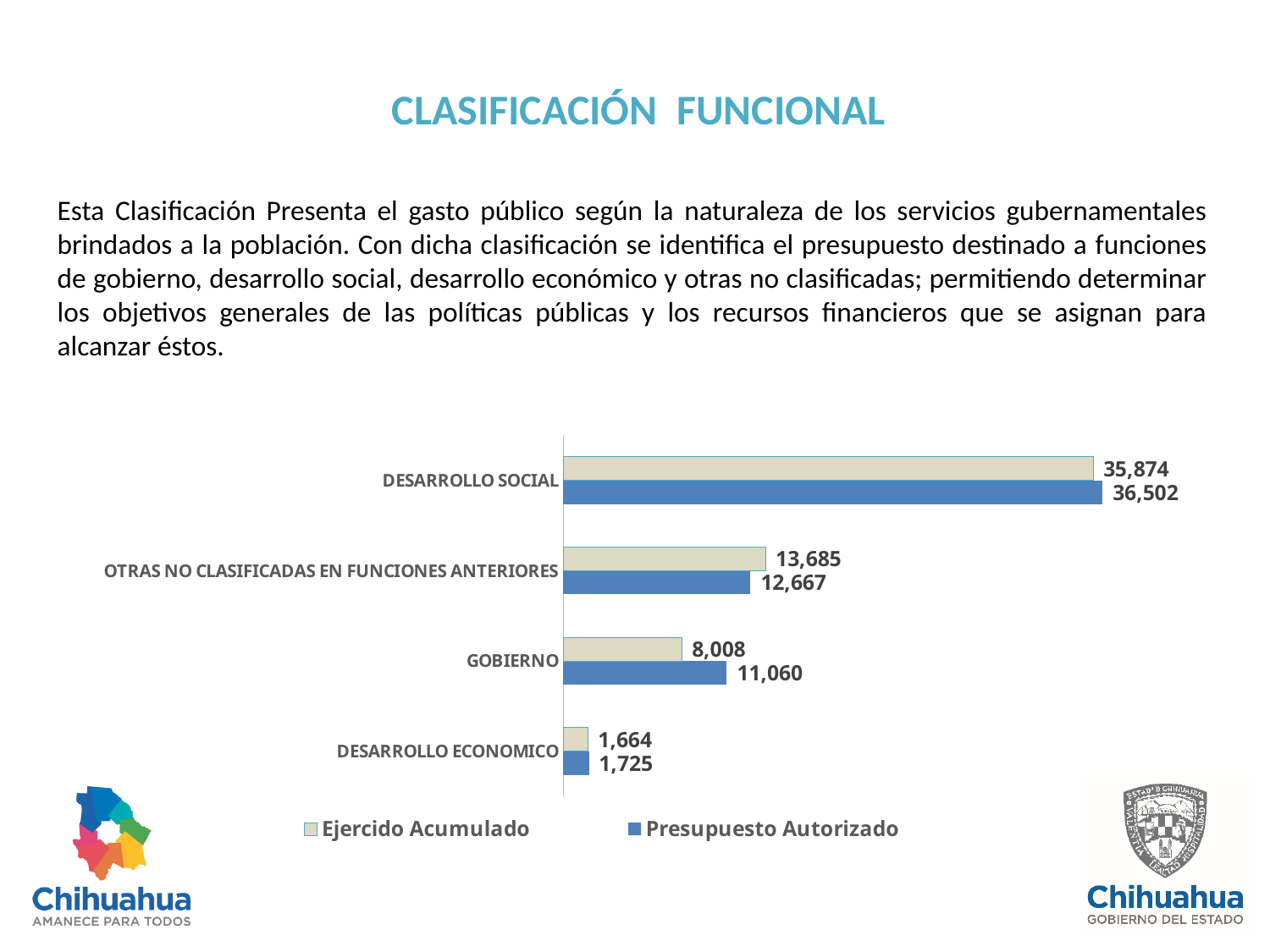
What is the difference between the Presupuesto Autorizado and Ejercido Acumulado values for GOBIERNO? 3,052 Which category has the highest Presupuesto Autorizado value? DESARROLLO SOCIAL For OTRAS NO CLASIFICADAS EN FUNCIONES ANTERIORES, which is larger: Ejercido Acumulado or Presupuesto Autorizado? Ejercido Acumulado How many series does the chart legend list? 2 What type of chart is shown on the slide? Bar chart What is the Presupuesto Autorizado value for OTRAS NO CLASIFICADAS EN FUNCIONES ANTERIORES? 12,667 What is the Ejercido Acumulado value for DESARROLLO ECONOMICO? 1,664 Which category has the lowest Ejercido Acumulado value? DESARROLLO ECONOMICO What is the difference between the Presupuesto Autorizado and Ejercido Acumulado values for DESARROLLO SOCIAL? 628 How many categories are shown in the chart? 4 What is the Presupuesto Autorizado value for GOBIERNO? 11,060 What is the Ejercido Acumulado value for DESARROLLO SOCIAL? 35,874